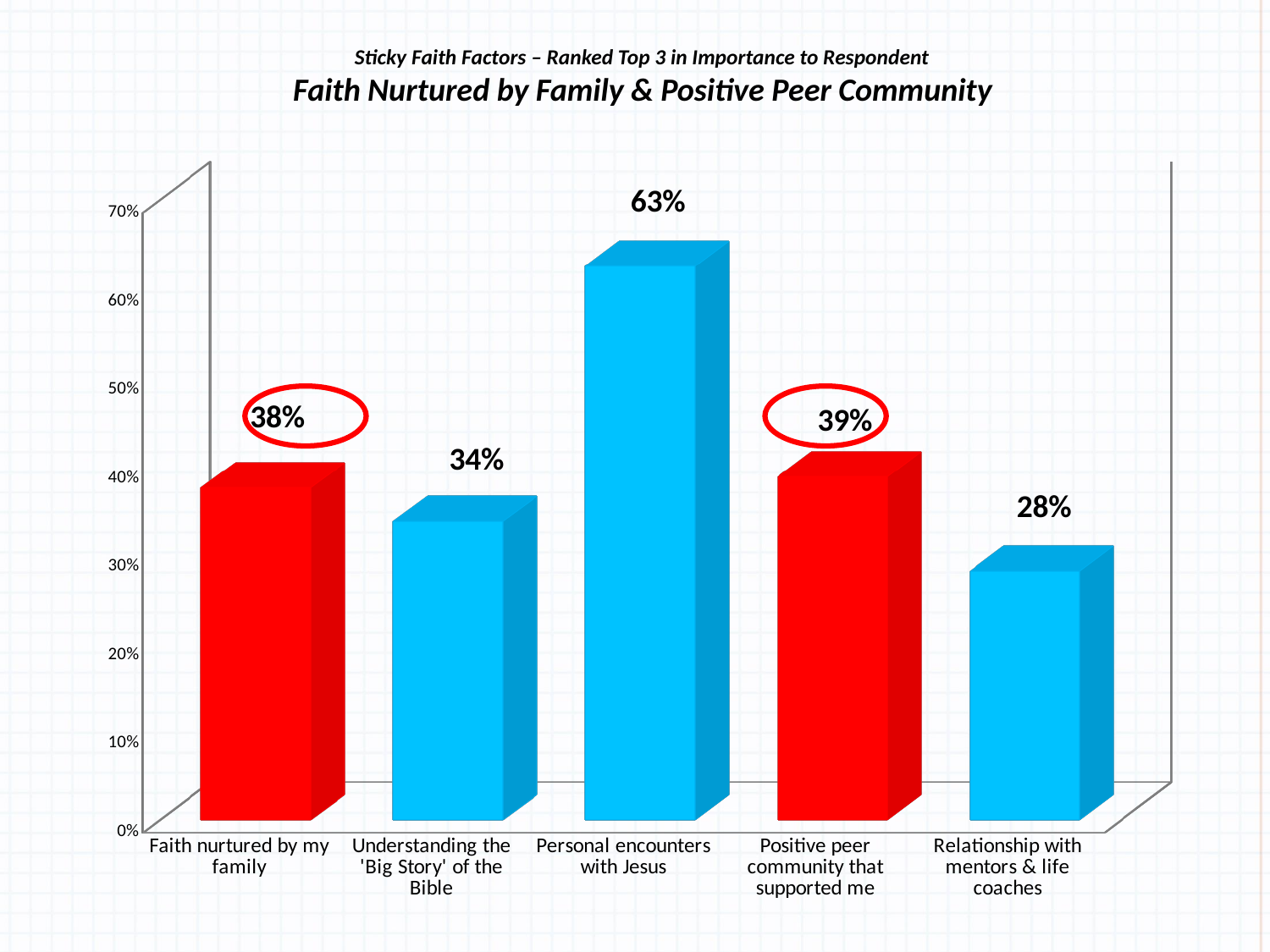
What is the value for 'Positive peer community that supported me'? 39% What is the value for 'Personal encounters with Jesus'? 63% What is the value for 'Faith nurtured by my family'? 38% What is the difference between 'Personal encounters with Jesus' and 'Understanding the 'Big Story' of the Bible'? 29% Which two bars are coloured red and circled? Faith nurtured by my family and Positive peer community that supported me How many categories are shown on the chart? 5 What is the value for 'Relationship with mentors & life coaches'? 28% Is the value for 'Personal encounters with Jesus' greater or less than 50%? greater Which category has the highest value? Personal encounters with Jesus What kind of chart is shown on the slide? bar chart Which category has the lowest value? Relationship with mentors & life coaches Which is larger: 'Understanding the 'Big Story' of the Bible' or 'Relationship with mentors & life coaches'? Understanding the 'Big Story' of the Bible